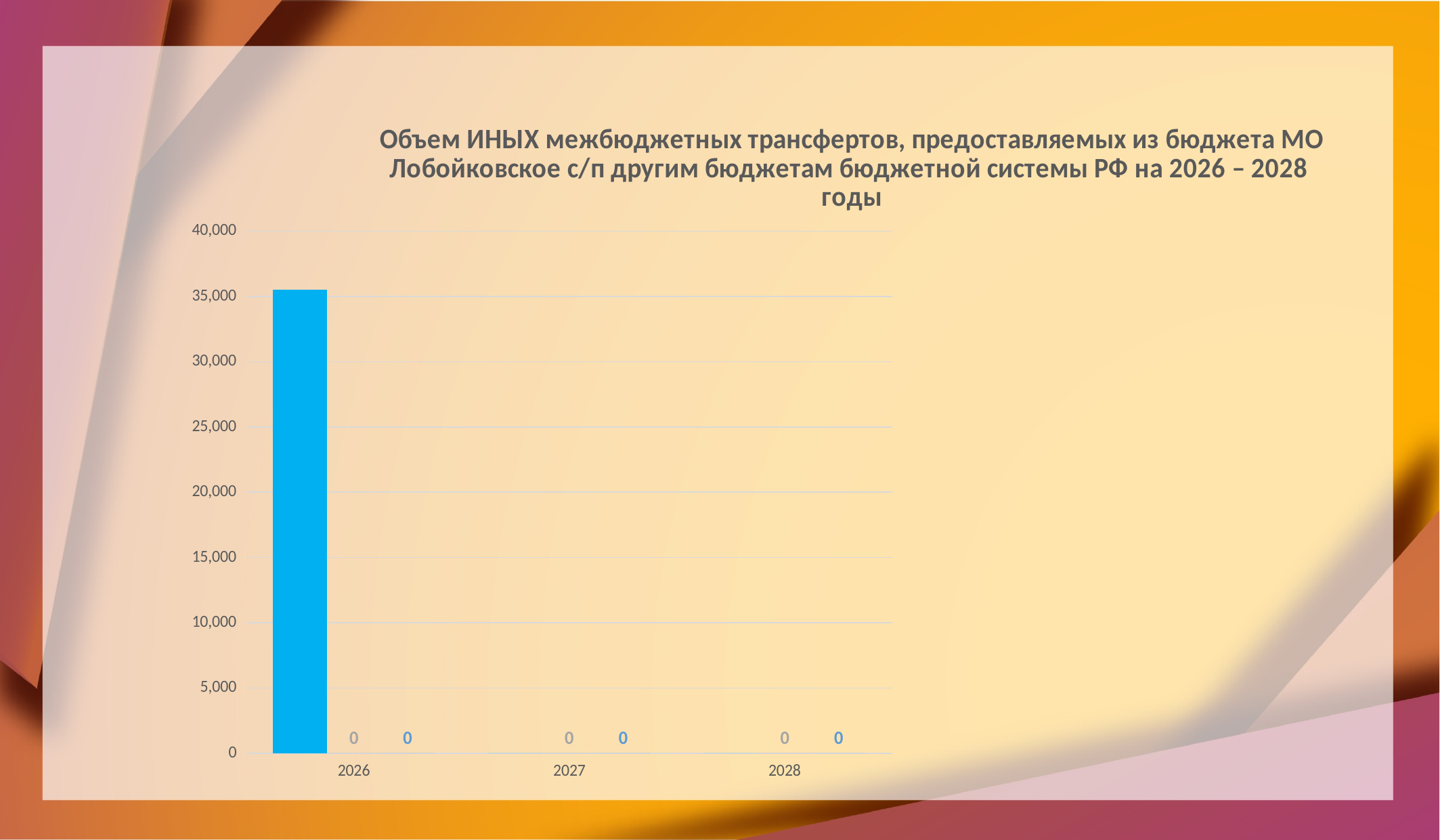
What is the highest value shown on the vertical axis of the chart? 40,000 Is the value of the bar for 2026 greater or less than 40,000? less How many years are shown on the x axis of the chart? 3 Which year has the highest bar in the chart? 2026 Do the values in the chart rise or fall from 2026 to 2028? fall What colour is the bar for 2026? blue What values are labelled for 2028 in the chart? 0 What kind of chart is shown on the slide? bar chart Which year has a larger bar, 2026 or 2027? 2026 Is the value of the bar for 2026 greater or less than 30,000? greater What values are labelled for 2027 in the chart? 0